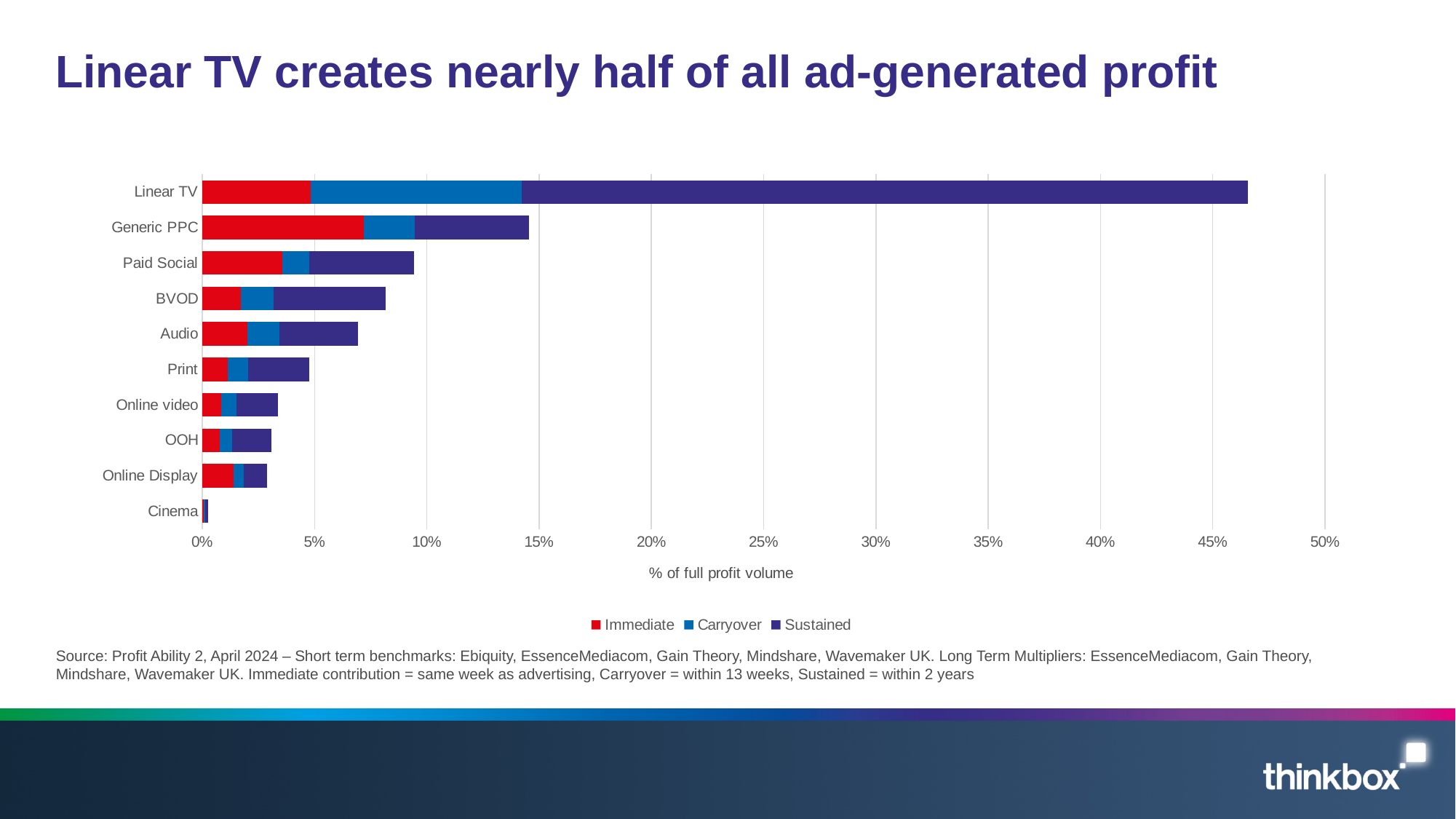
Is the total value for Generic PPC greater or less than 10%? greater Which series is shown in red in the legend? Immediate Which channel has the highest total share of full profit volume? Linear TV Is the total value for Online video greater or less than 5%? less How many series does the legend list? 3 Which has a larger total bar, Generic PPC or Paid Social? Generic PPC Which has a larger total bar, Audio or Print? Audio Which channel has the lowest total share of full profit volume? Cinema What is the label on the horizontal axis of the chart? % of full profit volume What kind of chart is shown on the slide? Stacked bar chart Is the total value for Linear TV greater or less than 45%? greater How many media channels (categories) are plotted on the chart? 10